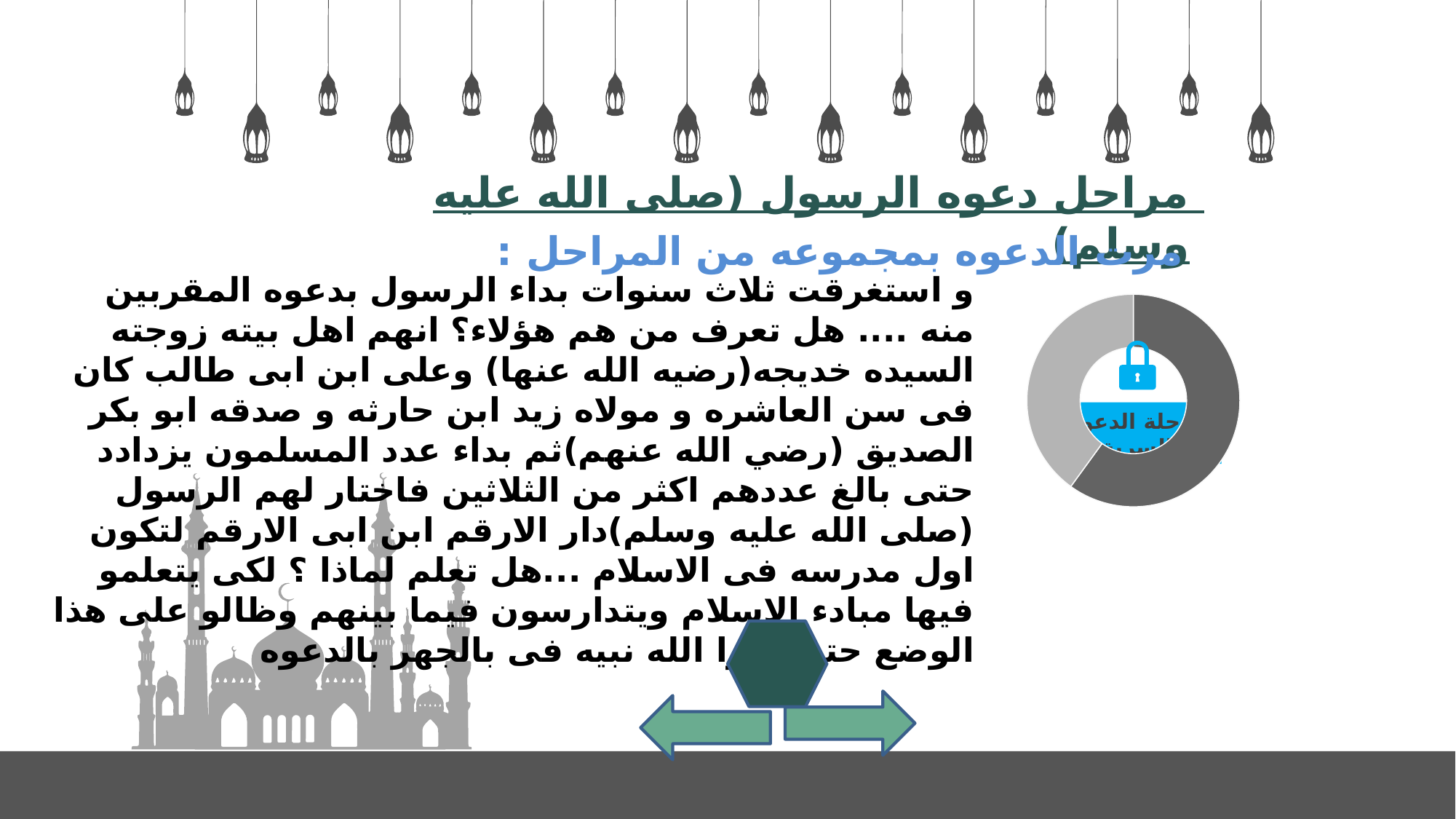
In the donut chart on the right side of the slide, which slice is the smallest? The light gray slice What two colours are used for the slices of the donut chart on the right side of the slide? Dark gray and light gray How many slices does the donut chart on the right side of the slide have? 2 What kind of chart is shown on the right side of the slide? Pie chart (donut) Does the donut chart on the right side of the slide show any data labels with values? No In the donut chart on the right side of the slide, which slice is larger, the dark gray one or the light gray one? The dark gray one